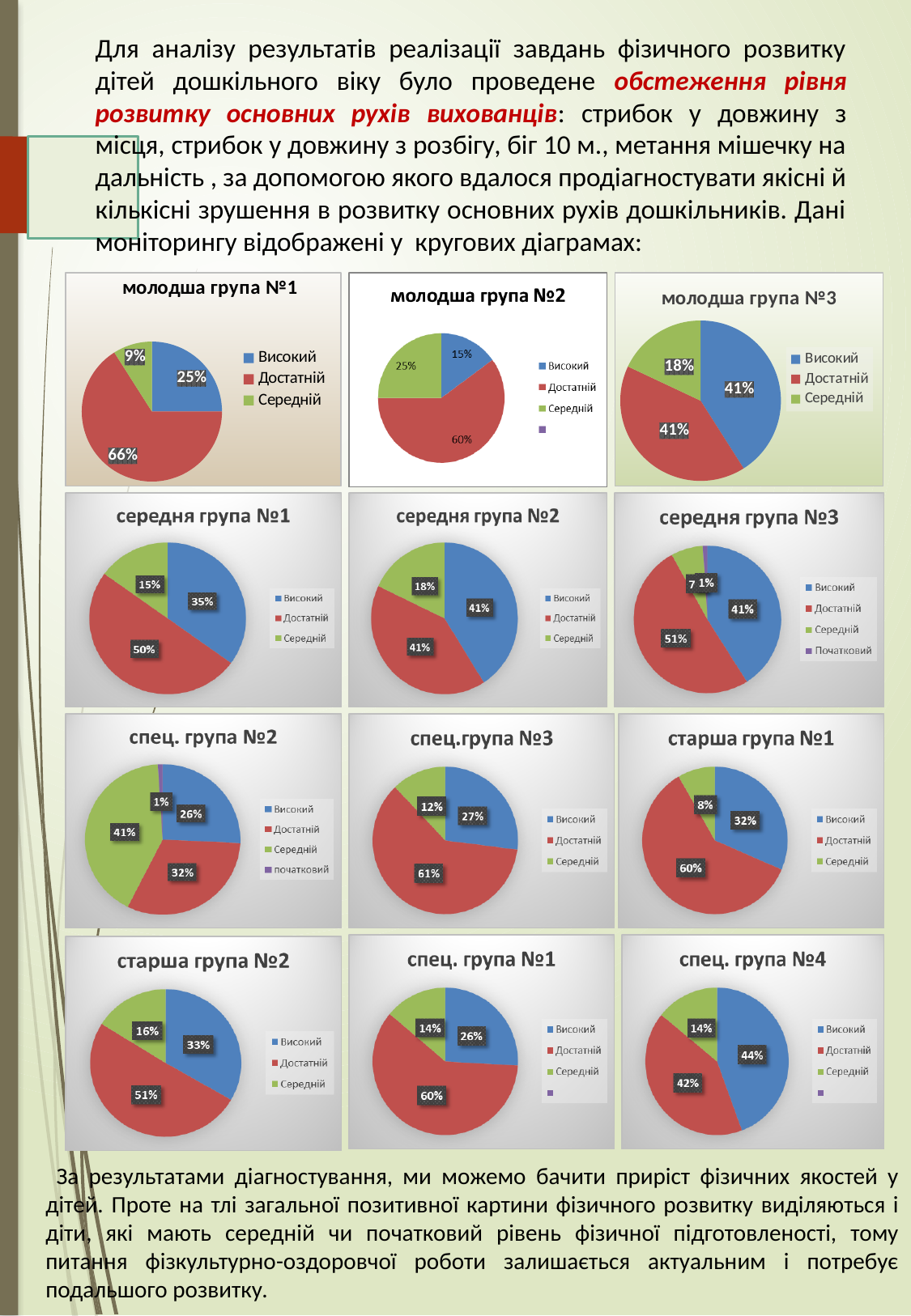
What kind of chart is "старша група №2"? Pie chart How many pie charts are shown on the slide? 12 In the chart titled "молодша група №1", what share does the "Достатній" slice have? 66% In the chart titled "спец. група №1", what is the difference between the "Достатній" and "Середній" shares? 46% In the chart titled "старша група №1", what is the difference between the "Достатній" and "Високий" shares? 28% In the chart titled "спец. група №4", which is larger: the "Високий" slice or the "Достатній" slice? Високий In the chart titled "спец.група №3", what share does the "Високий" slice have? 27% In the chart titled "молодша група №2", what share does the "Середній" slice have? 25% In the chart titled "середня група №3", how many entries does the legend list? 4 In the chart titled "спец. група №2", which category has the largest slice? Середній In the chart titled "середня група №1", how many slices does the pie have? 3 In the chart titled "середня група №3", which category has the smallest slice? Початковий